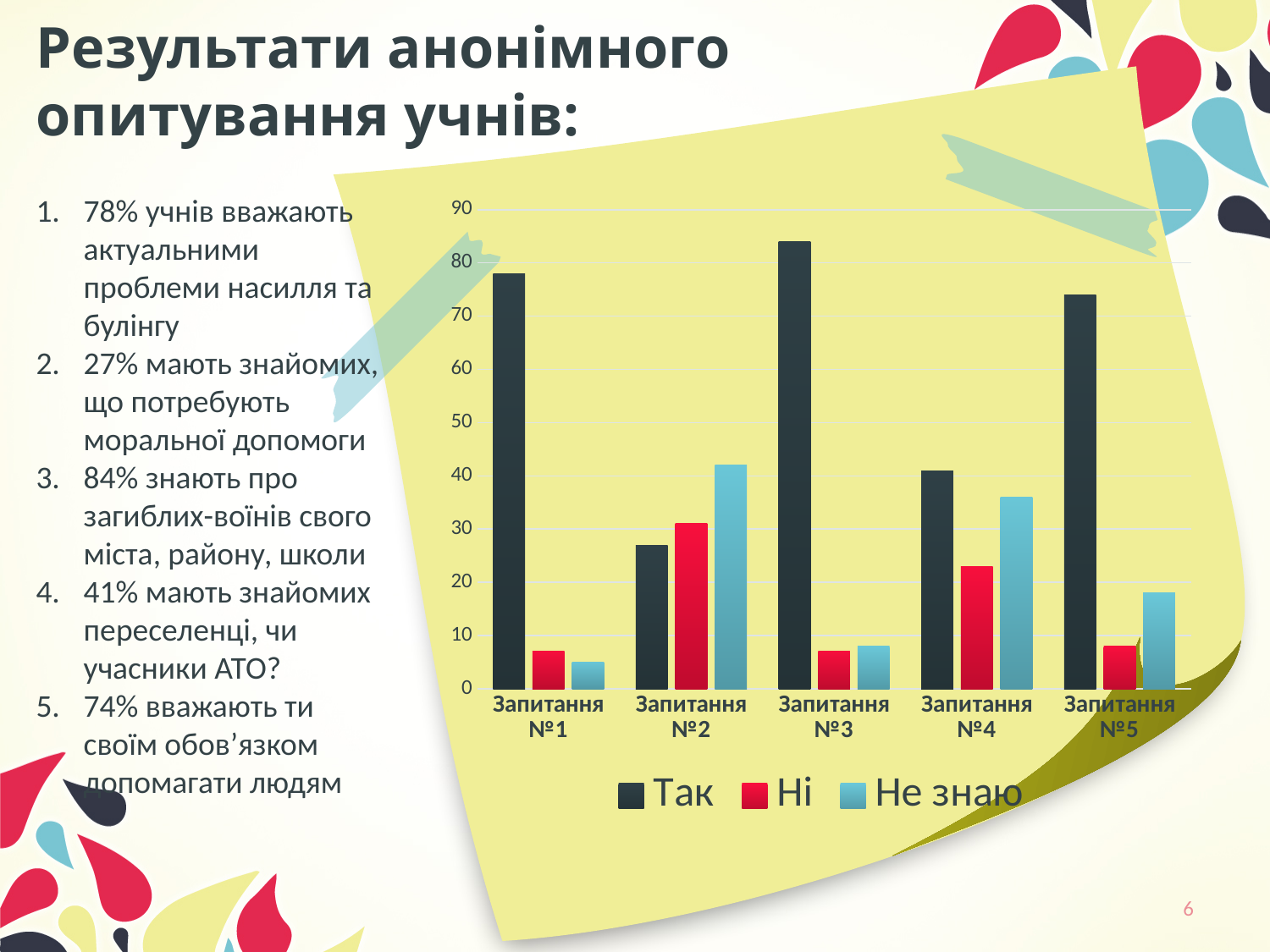
What kind of chart is shown on the slide? bar chart Which question has the lowest value for the "Так" series? Запитання №2 Is the "Так" value for Запитання №2 greater or less than 30? less How many series does the legend list? 3 Which is larger: the "Ні" value for Запитання №2 or the "Ні" value for Запитання №4? Запитання №2 How many question categories are shown on the x axis? 5 Which question has the highest value for the "Так" series? Запитання №3 What are the three entries in the chart legend? Так, Ні, Не знаю Is the "Не знаю" value for Запитання №4 greater or less than 40? less Is the "Так" value for Запитання №1 greater or less than 70? greater Which is larger: the "Не знаю" value for Запитання №2 or the "Не знаю" value for Запитання №5? Запитання №2